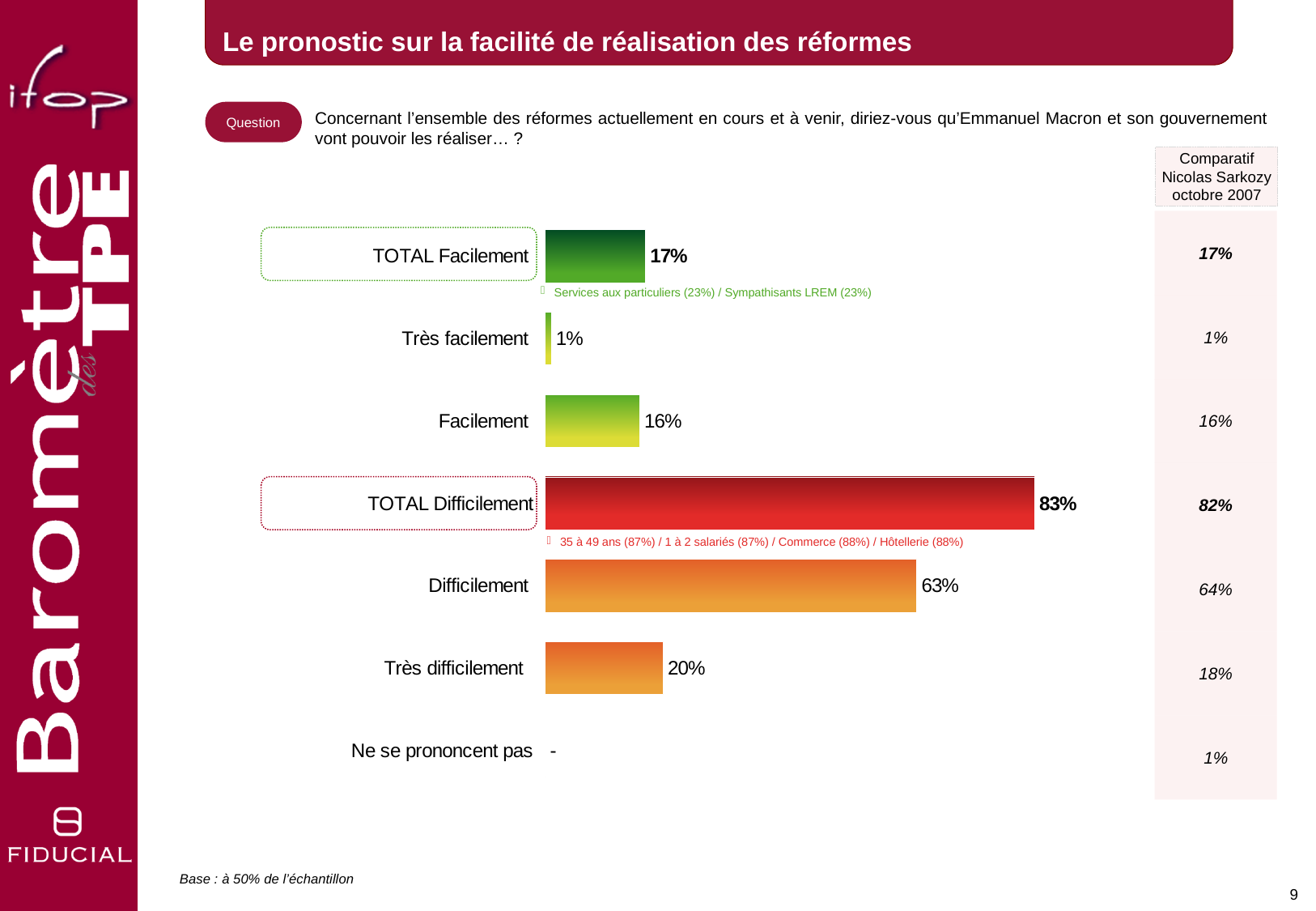
What is the value for Difficilement? 63% What is the value for TOTAL Difficilement? 83% What is the value for Très facilement? 1% What kind of chart is shown on the slide? Bar chart What is the value for TOTAL Facilement? 17% What is the value for Très difficilement? 20% In the Comparatif Nicolas Sarkozy octobre 2007 column, what is the value for TOTAL Difficilement? 82% Which category has the lowest value among Très facilement, Facilement, Difficilement and Très difficilement? Très facilement What is the difference between the values for Difficilement and Très difficilement? 43% What is the difference between the TOTAL Difficilement value and the Comparatif Nicolas Sarkozy octobre 2007 value for TOTAL Difficilement? 1% Which category has the highest value among Très facilement, Facilement, Difficilement and Très difficilement? Difficilement Which is larger, the value for Facilement or the value for Très difficilement? Très difficilement